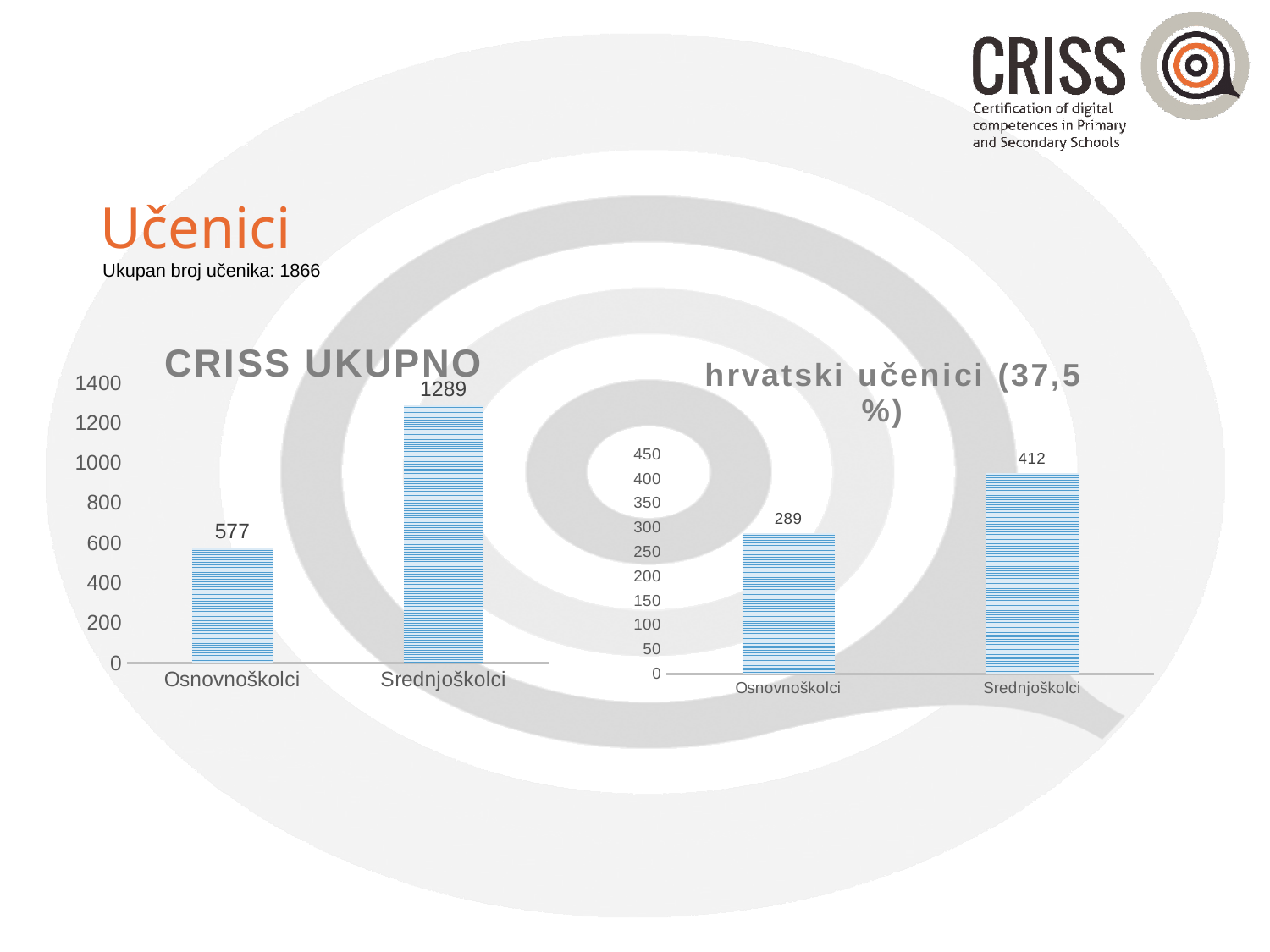
In the 'hrvatski učenici (37,5 %)' chart, which category has the lowest value? Osnovnoškolci In the 'hrvatski učenici (37,5 %)' chart, what is the value for Osnovnoškolci? 289 In the 'hrvatski učenici (37,5 %)' chart, which is larger: Osnovnoškolci or Srednjoškolci? Srednjoškolci What kind of chart is the 'hrvatski učenici (37,5 %)' chart? bar chart In the 'CRISS UKUPNO' chart, is the value for Osnovnoškolci greater or less than 600? less How many categories does the 'CRISS UKUPNO' chart show? 2 In the 'CRISS UKUPNO' chart, what is the value for Osnovnoškolci? 577 In the 'hrvatski učenici (37,5 %)' chart, what is the value for Srednjoškolci? 412 In the 'CRISS UKUPNO' chart, what is the difference between the values for Srednjoškolci and Osnovnoškolci? 712 In the 'CRISS UKUPNO' chart, which category has the highest value? Srednjoškolci In the 'hrvatski učenici (37,5 %)' chart, what is the difference between the values for Srednjoškolci and Osnovnoškolci? 123 In the 'CRISS UKUPNO' chart, what is the value for Srednjoškolci? 1289